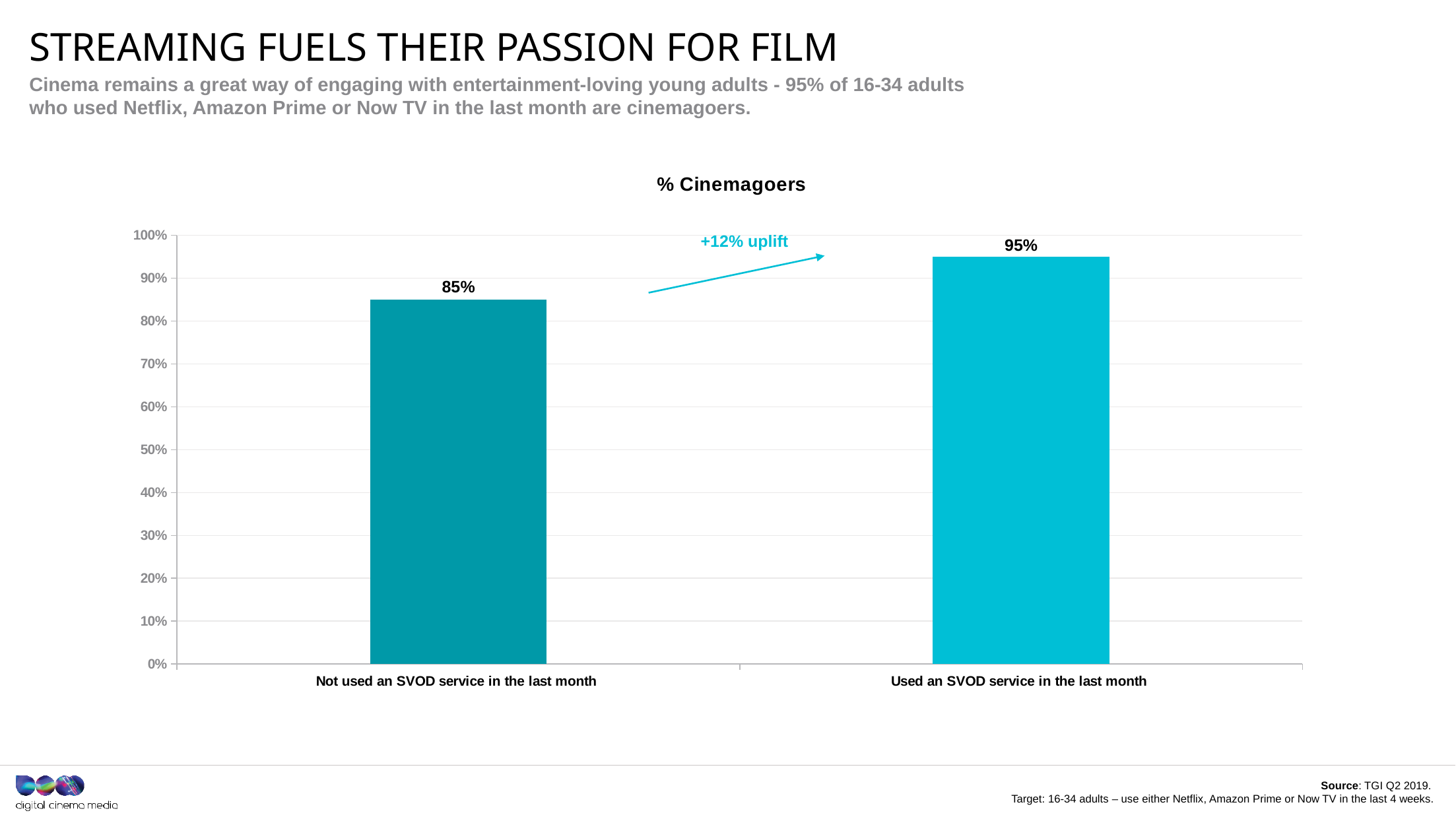
How many categories are shown on the chart? 2 Which category has the lowest value? Not used an SVOD service in the last month What is the value for 'Not used an SVOD service in the last month'? 85% What uplift is annotated on the chart between the two bars? +12% uplift Which is larger: the value for 'Used an SVOD service in the last month' or 'Not used an SVOD service in the last month'? Used an SVOD service in the last month What is the difference between the values for 'Used an SVOD service in the last month' and 'Not used an SVOD service in the last month'? 10% What kind of chart is shown on the slide? Bar chart Which category has the highest value? Used an SVOD service in the last month What is the title of the chart? % Cinemagoers Is the value for 'Not used an SVOD service in the last month' greater or less than 90%? less Is the value for 'Used an SVOD service in the last month' greater or less than 90%? greater What is the value for 'Used an SVOD service in the last month'? 95%